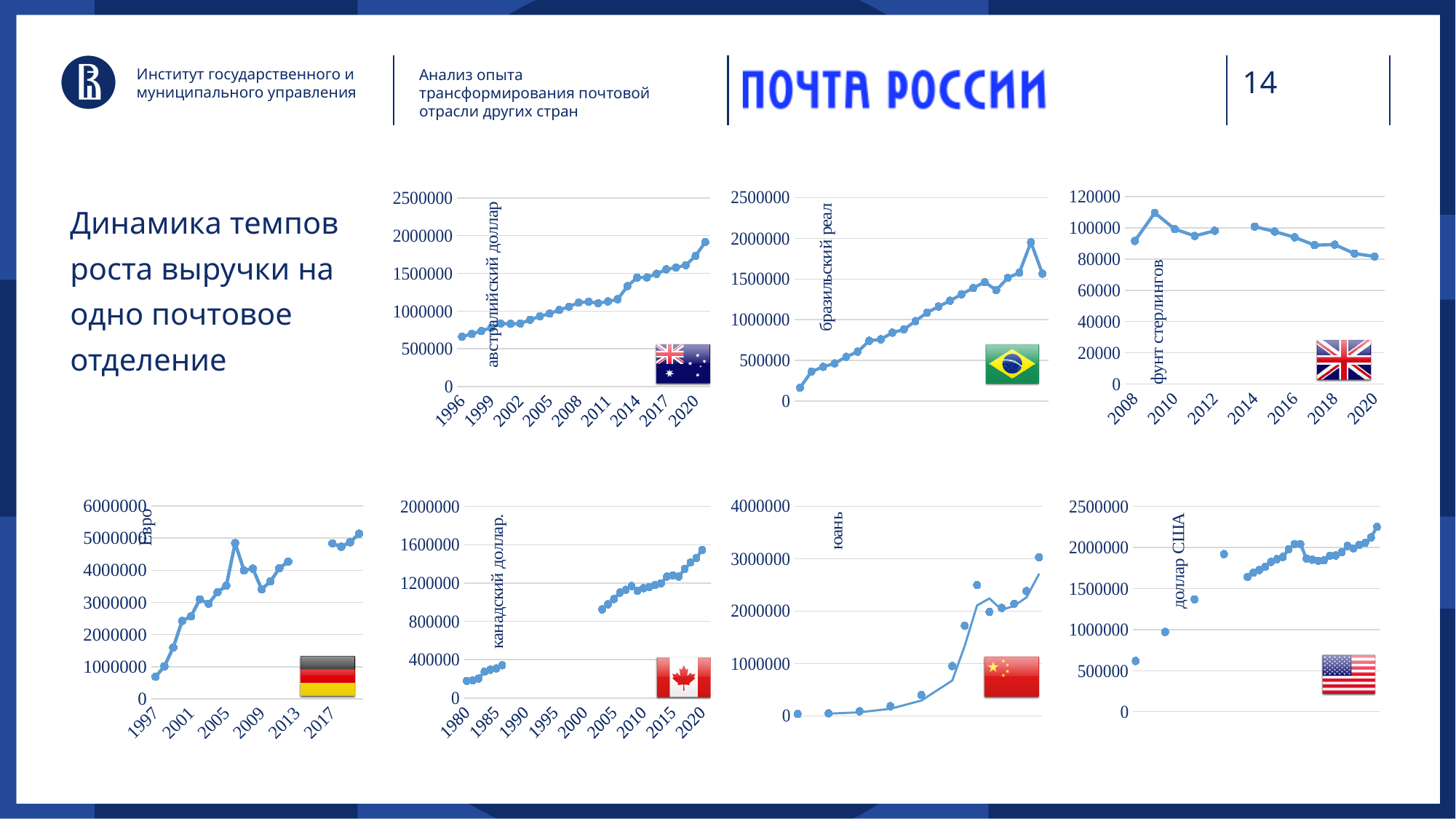
In the chart with the UK flag (фунт стерлингов), do the values rise or fall from 2009 to 2020? fall In the chart with the Australian flag, do the values rise or fall from 1996 to 2020? rise In the chart with the German flag (Евро), is the value for 1997 greater or less than 1000000? less In the chart with the Australian flag, is the value for 2020 greater or less than 1500000? greater What kind of chart is used for the Australian dollar revenue data (top-left chart)? line chart In the chart with the UK flag, which year has the highest value? 2009 In the chart with the Canadian flag, is the value for 1980 greater or less than 400000? less What is the y-axis label of the chart with the Brazilian flag? бразильский реал